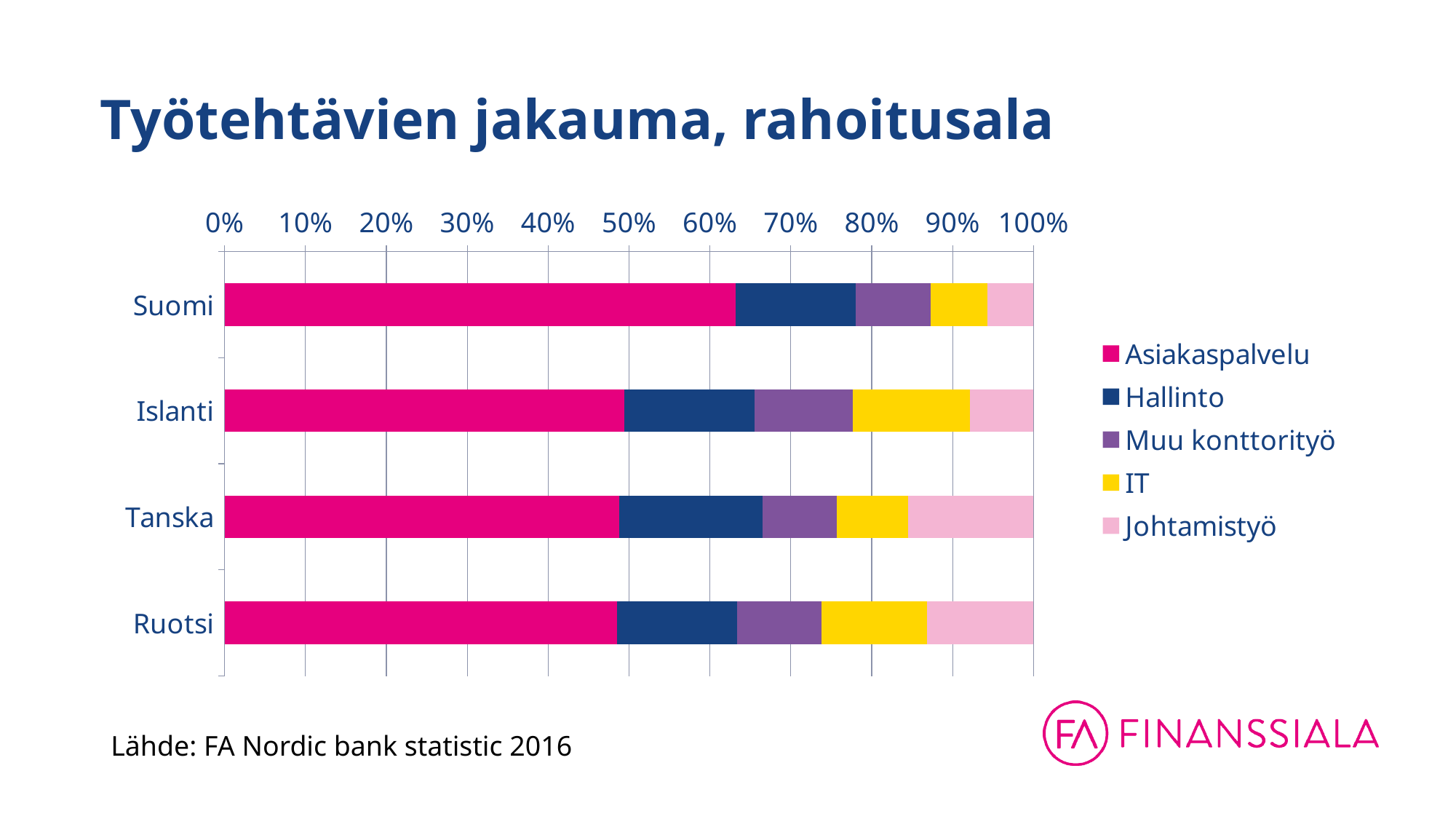
What kind of chart is shown on the slide? Stacked bar chart Which has the larger IT share, Islanti or Suomi? Islanti Is the Johtamistyö share for Tanska greater or less than 10%? greater What is the title of the chart? Työtehtävien jakauma, rahoitusala Which has the larger Johtamistyö share, Tanska or Suomi? Tanska How many series does the legend list? 5 Which series is shown in yellow? IT Which country has the largest Asiakaspalvelu share? Suomi Is the Johtamistyö share for Suomi greater or less than 10%? less What does the full stacked bar for Ruotsi add up to? 100% Is the Asiakaspalvelu share for Suomi greater or less than 60%? greater How many countries are shown on the chart? 4